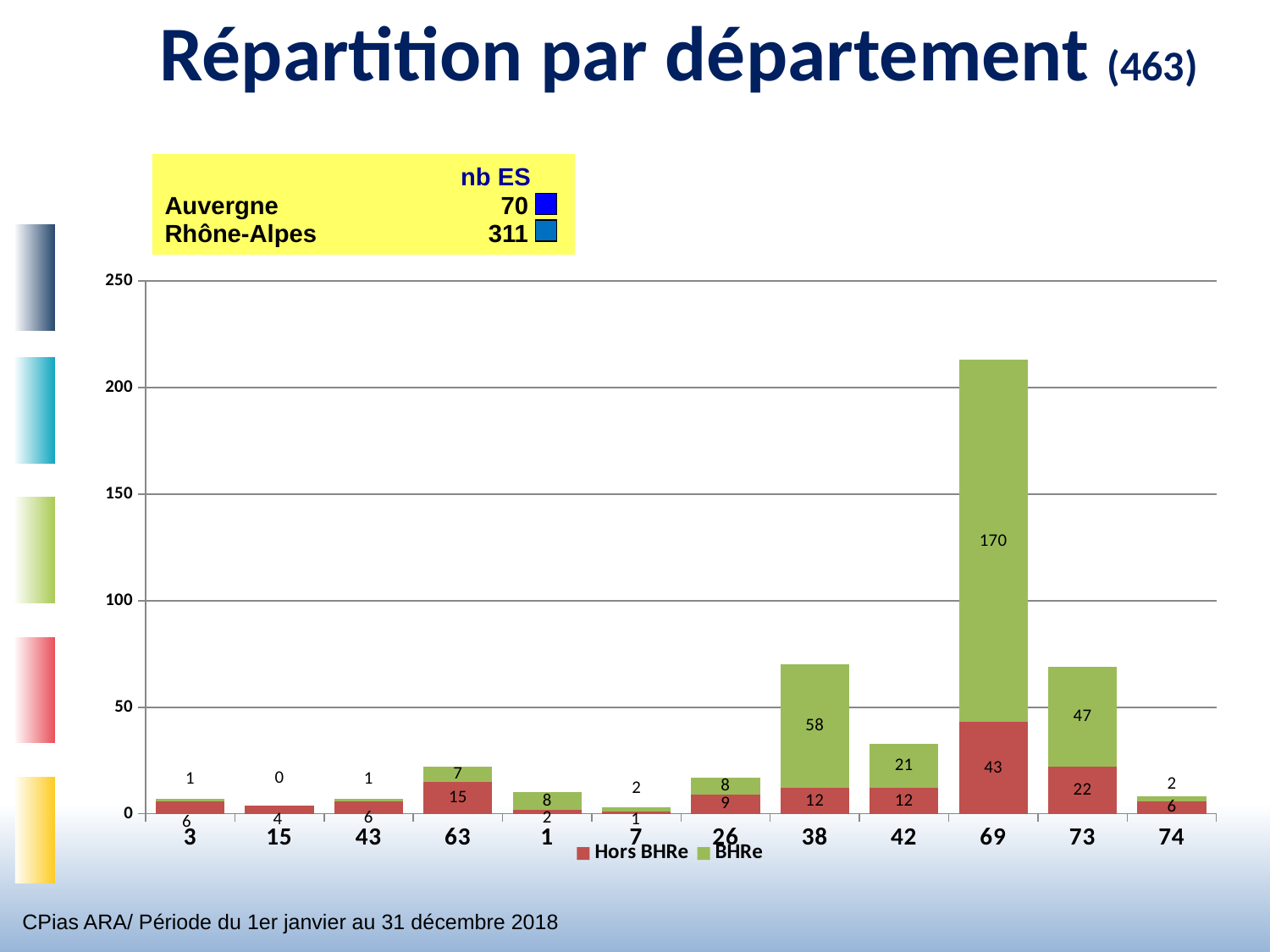
How many departments (categories) are shown on the x axis of the chart? 12 Which department has the highest BHRe value? 69 What is the BHRe value for department 38? 58 Which department has the lowest BHRe value? 15 What is the Hors BHRe value for department 73? 22 What is the difference between the BHRe values for departments 38 and 73? 11 Which is larger, the Hors BHRe value for department 63 or for department 42? 63 How many series does the chart legend list? 2 What is the total of the stacked bar for department 69? 213 What type of chart is shown on the slide? stacked bar chart What is the BHRe value for department 69? 170 Is the total stacked bar for department 69 greater or less than 200? greater